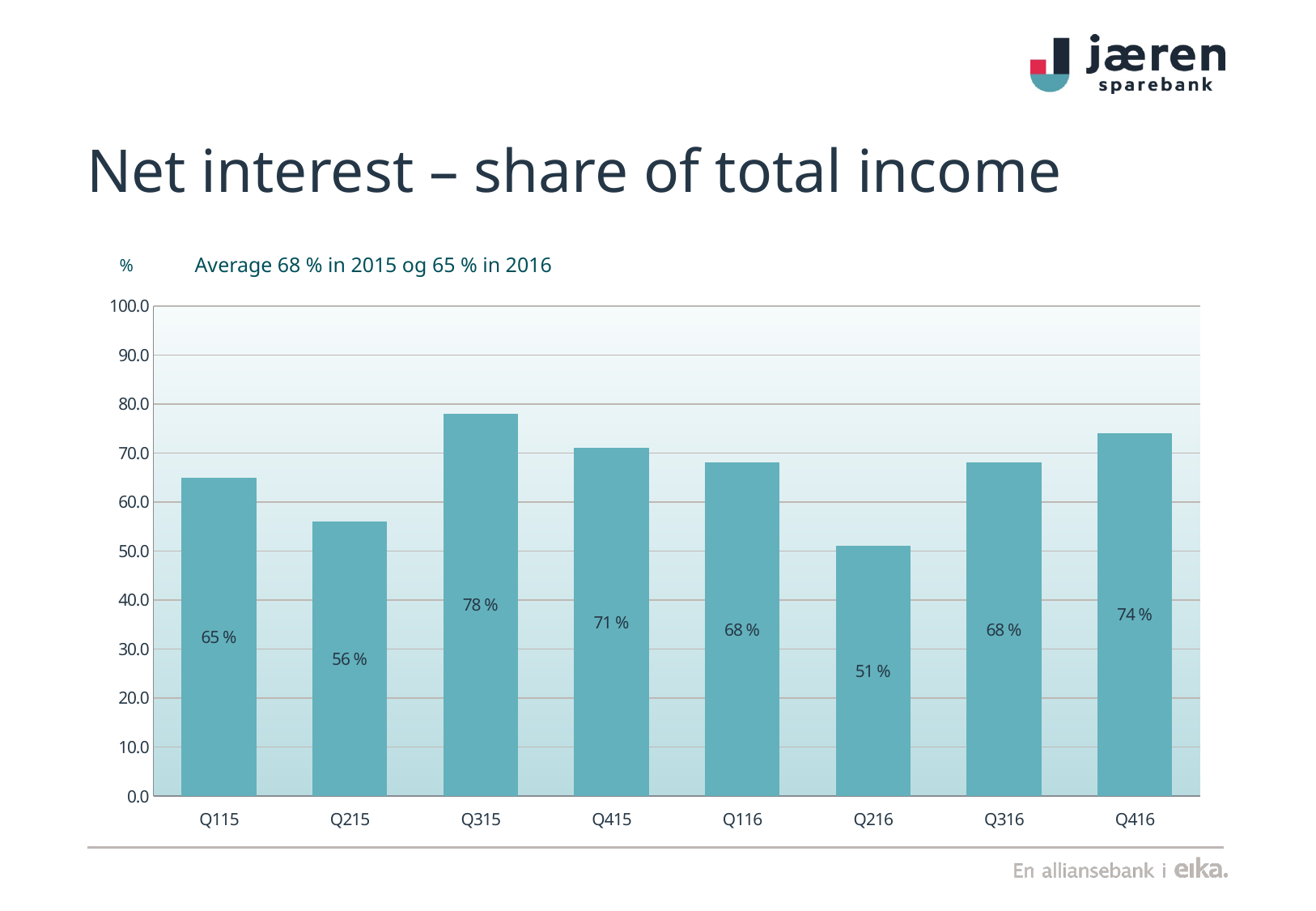
According to the chart subtitle, what was the average share in 2016? 65 % What is the difference between the values for Q315 and Q216? 27 % Is the value for Q215 greater or less than 60? less What kind of chart is shown on the slide? bar chart How many quarters are shown on the x axis? 8 Which is larger, the value for Q415 or the value for Q215? Q415 What is the value shown for Q216? 51 % What is the net interest share of total income for Q315? 78 % Which quarter has the lowest net interest share of total income? Q216 What is the value shown for Q416? 74 % What is the difference between the values for Q416 and Q115? 9 % Which quarter has the highest net interest share of total income? Q315